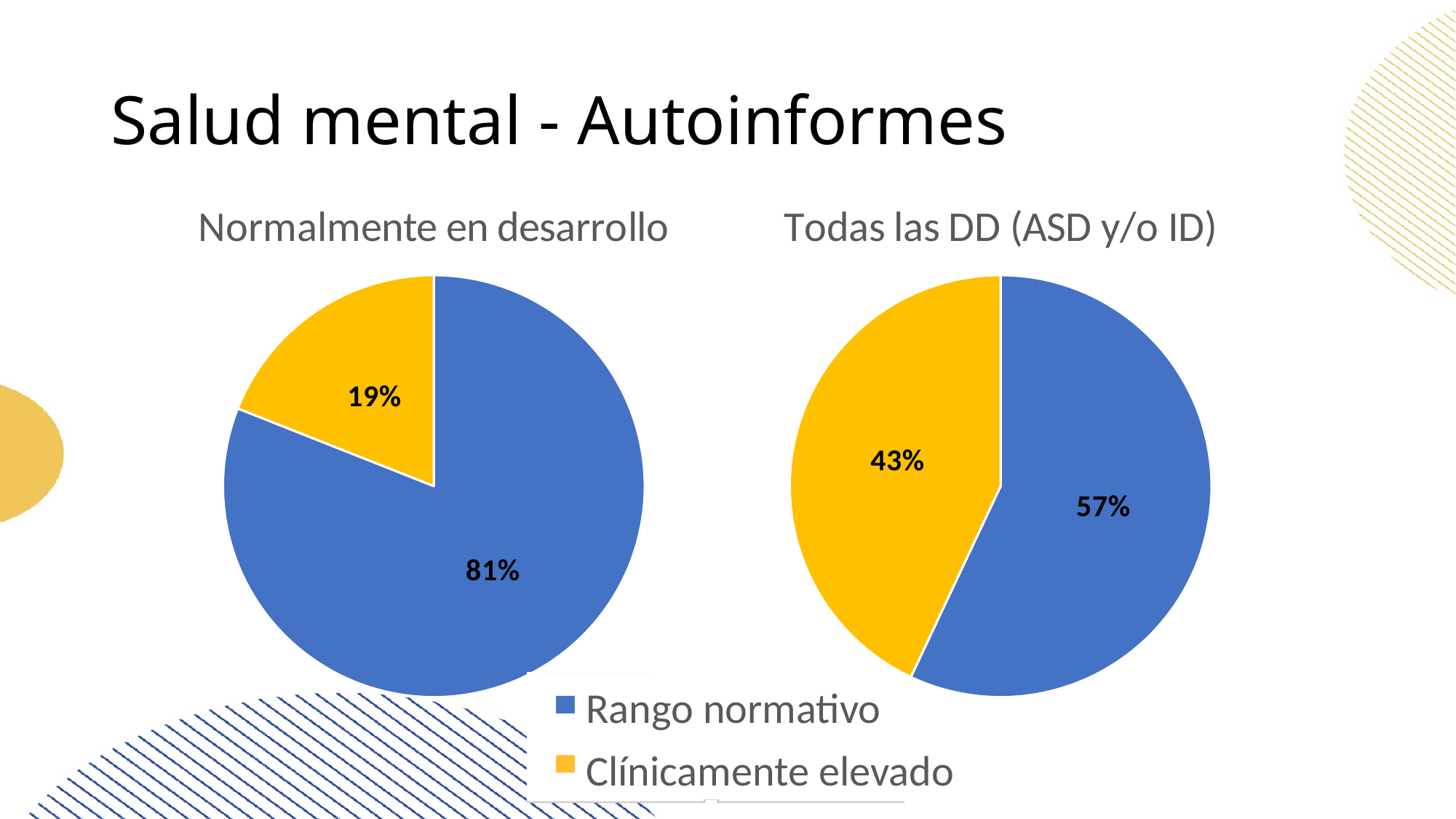
What kind of chart is used for 'Normalmente en desarrollo'? Pie chart In the 'Normalmente en desarrollo' pie chart, what share is labelled for Clínicamente elevado? 19% In the 'Todas las DD (ASD y/o ID)' pie chart, which slice is the largest? Rango normativo In the 'Normalmente en desarrollo' pie chart, which slice is the smallest? Clínicamente elevado In the 'Todas las DD (ASD y/o ID)' pie chart, what share is labelled for Rango normativo? 57% Which chart has the larger Clínicamente elevado share, 'Normalmente en desarrollo' or 'Todas las DD (ASD y/o ID)'? Todas las DD (ASD y/o ID) How many slices does the 'Todas las DD (ASD y/o ID)' pie chart have? 2 In the 'Todas las DD (ASD y/o ID)' pie chart, what share is labelled for Clínicamente elevado? 43% What colour represents Clínicamente elevado in the pie charts? Yellow How many entries does the legend list? 2 What is the difference between the Clínicamente elevado share in the 'Todas las DD (ASD y/o ID)' chart and in the 'Normalmente en desarrollo' chart? 24%